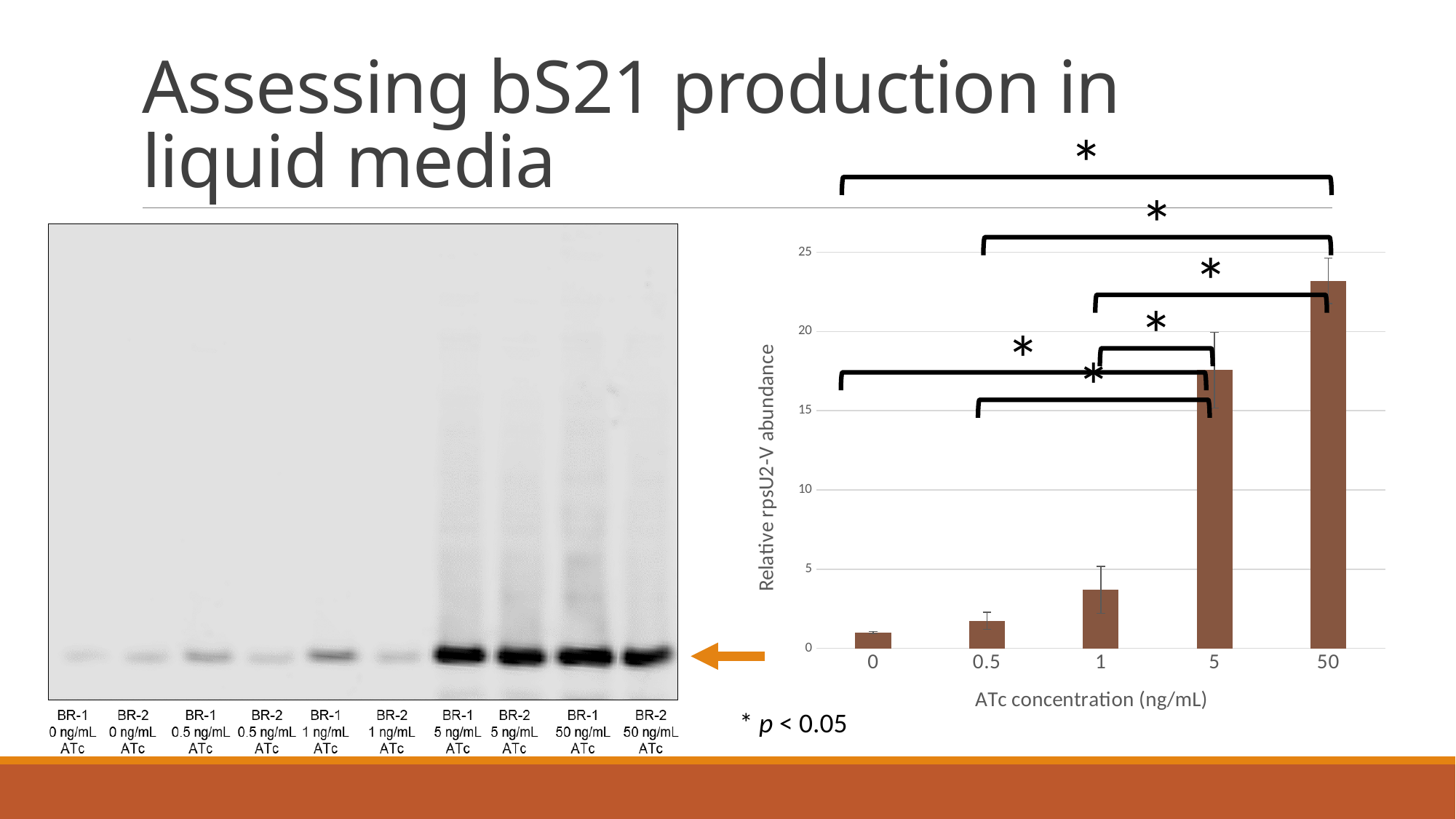
How many ATc concentration categories are plotted in the bar chart? 5 Is the relative rpsU2-V abundance at 5 ng/mL ATc greater or less than 15? greater Is the relative rpsU2-V abundance at 1 ng/mL ATc greater or less than 5? less Which ATc concentration has the highest relative rpsU2-V abundance? 50 What is the label of the y axis of the bar chart? Relative rpsU2-V abundance Which has a larger relative rpsU2-V abundance, 1 ng/mL or 5 ng/mL ATc? 5 ng/mL Is the relative rpsU2-V abundance at 0.5 ng/mL ATc greater or less than 5? less What is the label of the x axis of the bar chart? ATc concentration (ng/mL) Do the bar values rise or fall as ATc concentration increases along the x axis? rise Which ATc concentration has the lowest relative rpsU2-V abundance? 0 What kind of chart is shown on the right side of the slide? bar chart